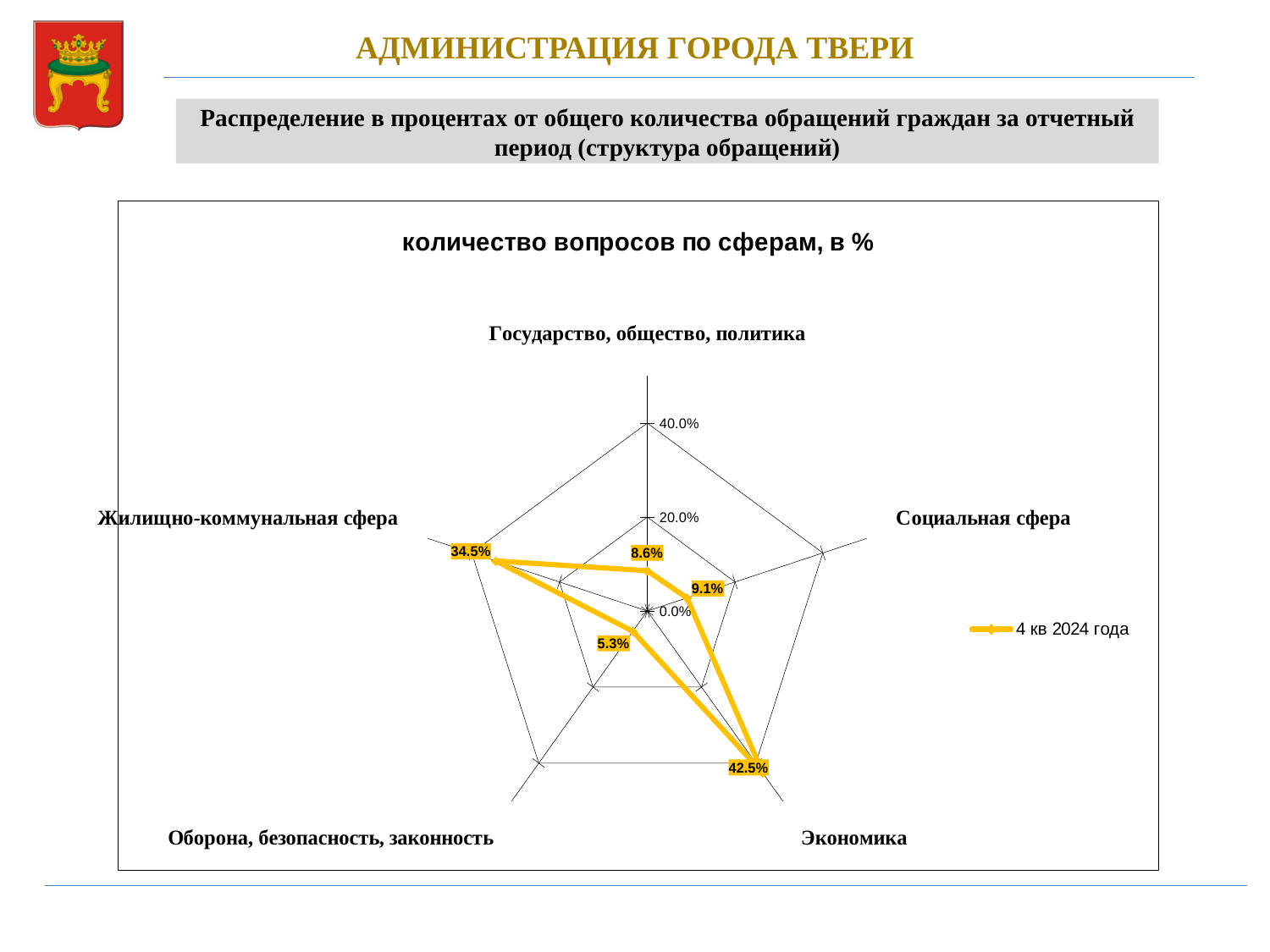
What is the value for Экономика? 42.5% What is the value for Жилищно-коммунальная сфера? 34.5% What is the value for Оборона, безопасность, законность? 5.3% What series does the legend list? 4 кв 2024 года Which is larger: the value for Социальная сфера or for Государство, общество, политика? Социальная сфера Which category has the highest value? Экономика Is the value for Экономика greater or less than 40.0%? greater How many categories are plotted on the radar chart? 5 What type of chart is shown on the slide? Radar chart What is the value for Социальная сфера? 9.1% What is the difference between the values for Экономика and Жилищно-коммунальная сфера? 8.0% Which category has the lowest value? Оборона, безопасность, законность